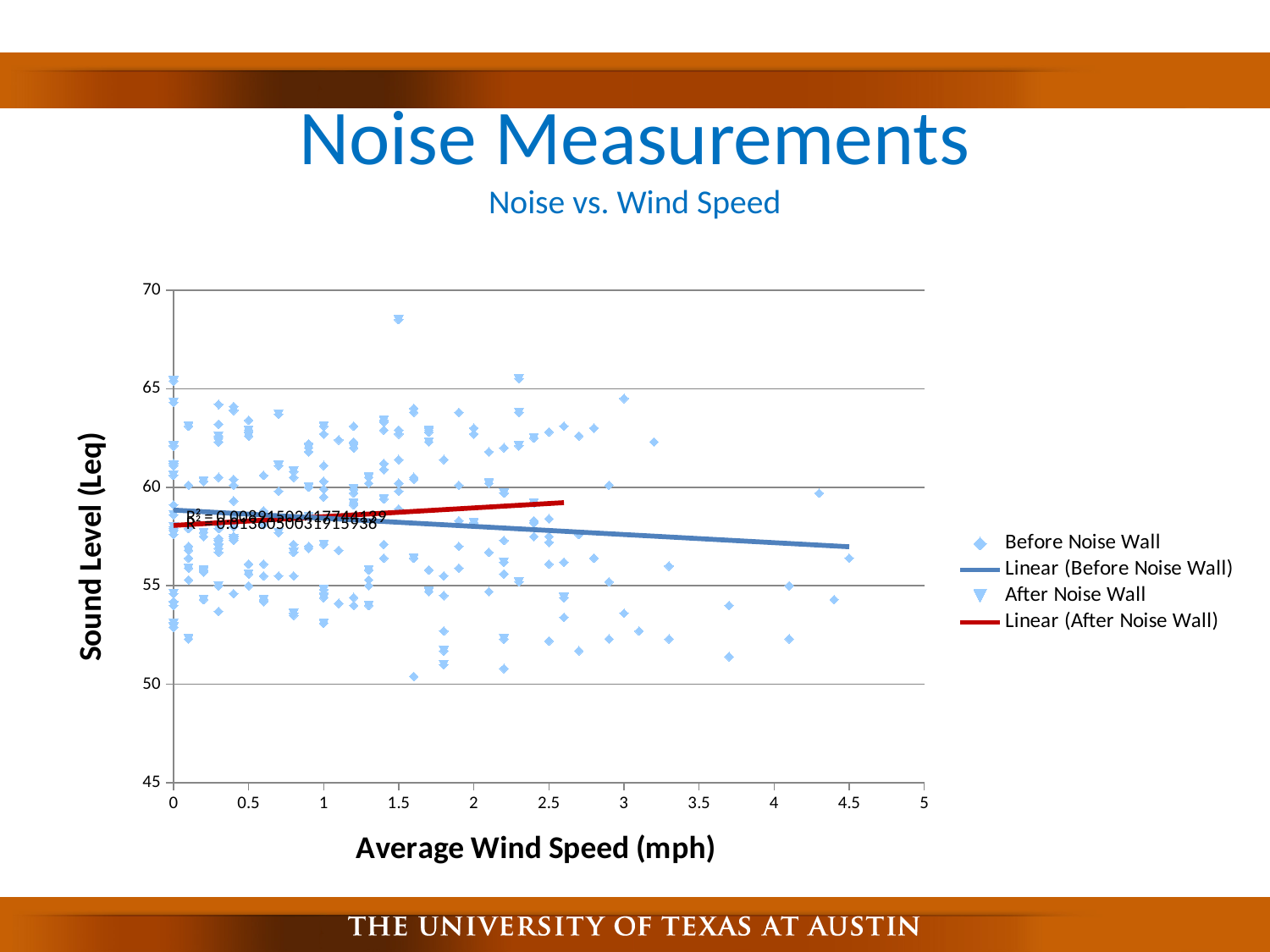
What is the label of the x axis? Average Wind Speed (mph) Is the highest plotted sound level on the chart greater or less than 65? greater Does the 'Linear (Before Noise Wall)' trendline rise or fall as wind speed increases? Fall Is the value of the 'Linear (After Noise Wall)' trendline at its right end (around 2.6 mph) greater or less than 55? greater What kind of chart is shown on the slide? Scatter chart What is the maximum value shown on the y axis? 70 How many entries does the chart legend list? 4 Does the 'Linear (After Noise Wall)' trendline rise or fall as wind speed increases? Rise Which series' trendline extends further along the x axis, 'Linear (Before Noise Wall)' or 'Linear (After Noise Wall)'? Linear (Before Noise Wall) Is the lowest plotted sound level on the chart greater or less than 55? less What is the title of the chart? Noise vs. Wind Speed